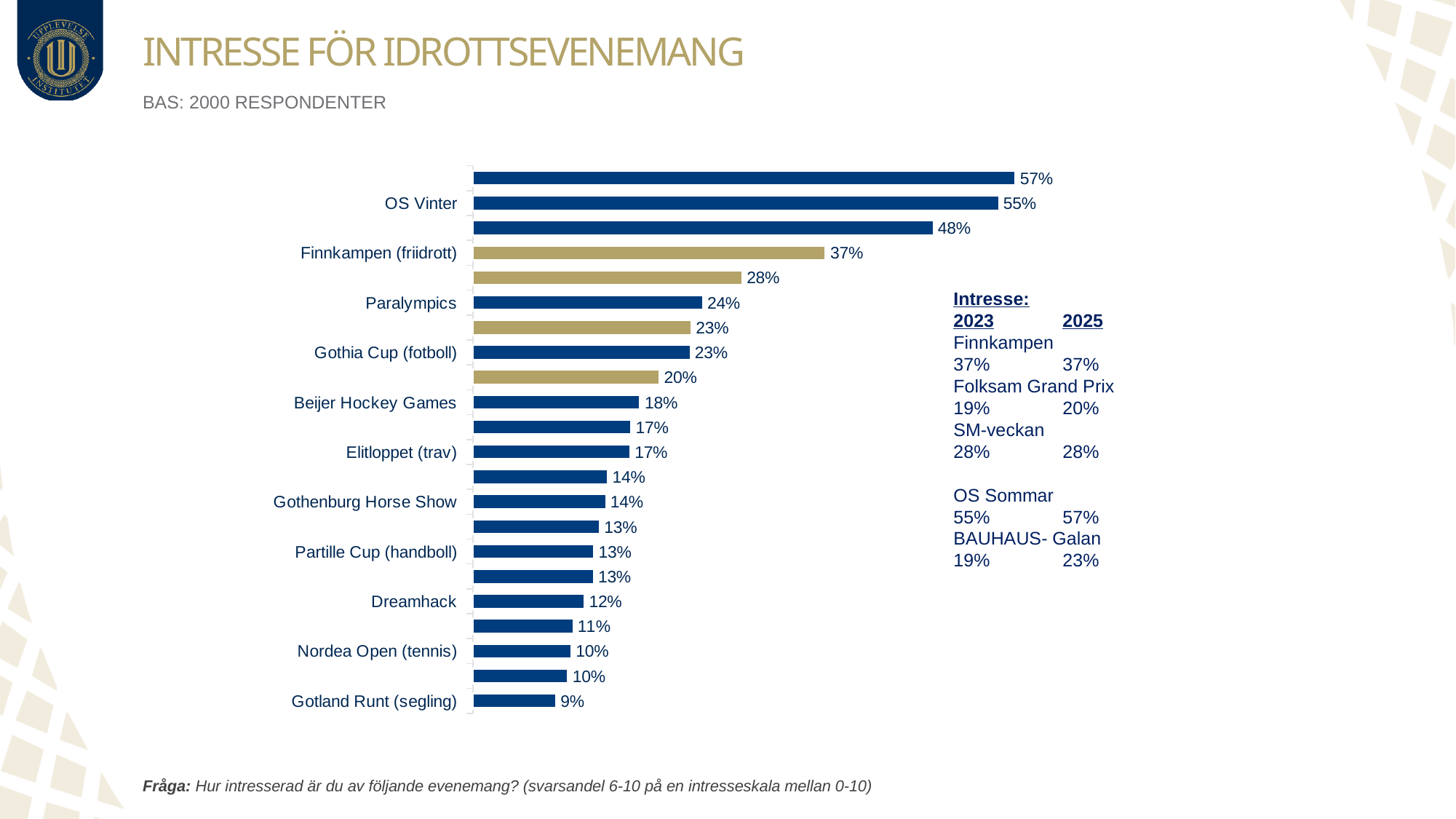
How many bars are plotted in the chart? 22 What is the value for Finnkampen (friidrott)? 37% What is the value for Gotland Runt (segling)? 9% What kind of chart is shown on the slide? Bar chart What is the value for OS Vinter? 55% What is the difference between the values for OS Vinter and Finnkampen (friidrott)? 18 percentage points Do the bar values increase or decrease from the top of the chart to the bottom? Decrease Which is larger, the value for Paralympics or the value for Gothia Cup (fotboll)? Paralympics Which labelled category has the lowest value? Gotland Runt (segling) What is the value for Beijer Hockey Games? 18% What is the title of the slide containing the chart? INTRESSE FÖR IDROTTSEVENEMANG What is the value for Paralympics? 24%